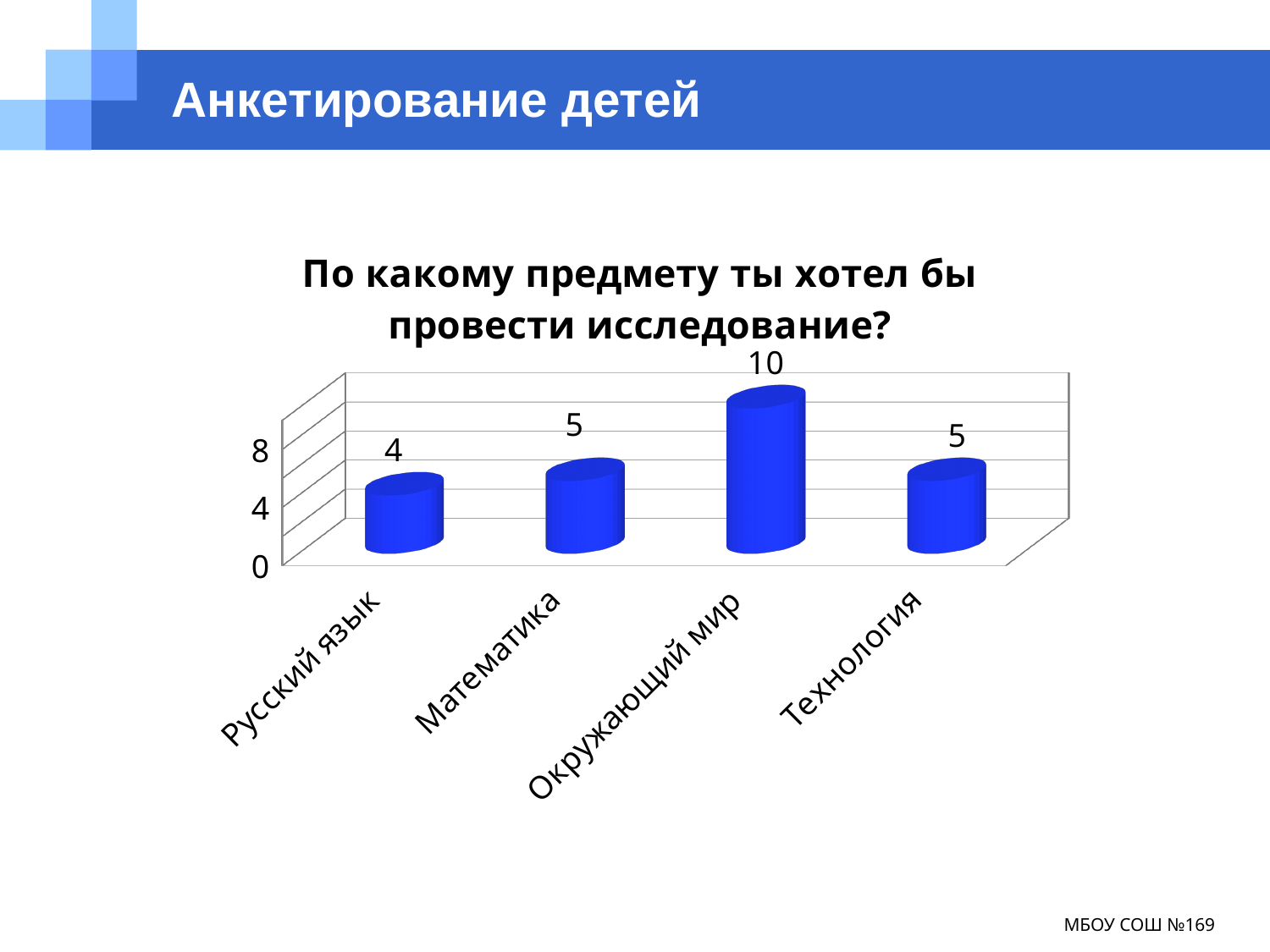
What is the value for Русский язык? 4 Which is larger, the value for Математика or the value for Русский язык? Математика Which subject has the highest value? Окружающий мир How many subjects are shown in the chart? 4 Which subject has the lowest value? Русский язык What is the difference between the values for Окружающий мир and Русский язык? 6 What is the title of the chart? По какому предмету ты хотел бы провести исследование? What is the value for Технология? 5 Is the value for Окружающий мир greater or less than 8? greater What kind of chart is shown on the slide? bar chart What is the value for Математика? 5 What is the value for Окружающий мир? 10